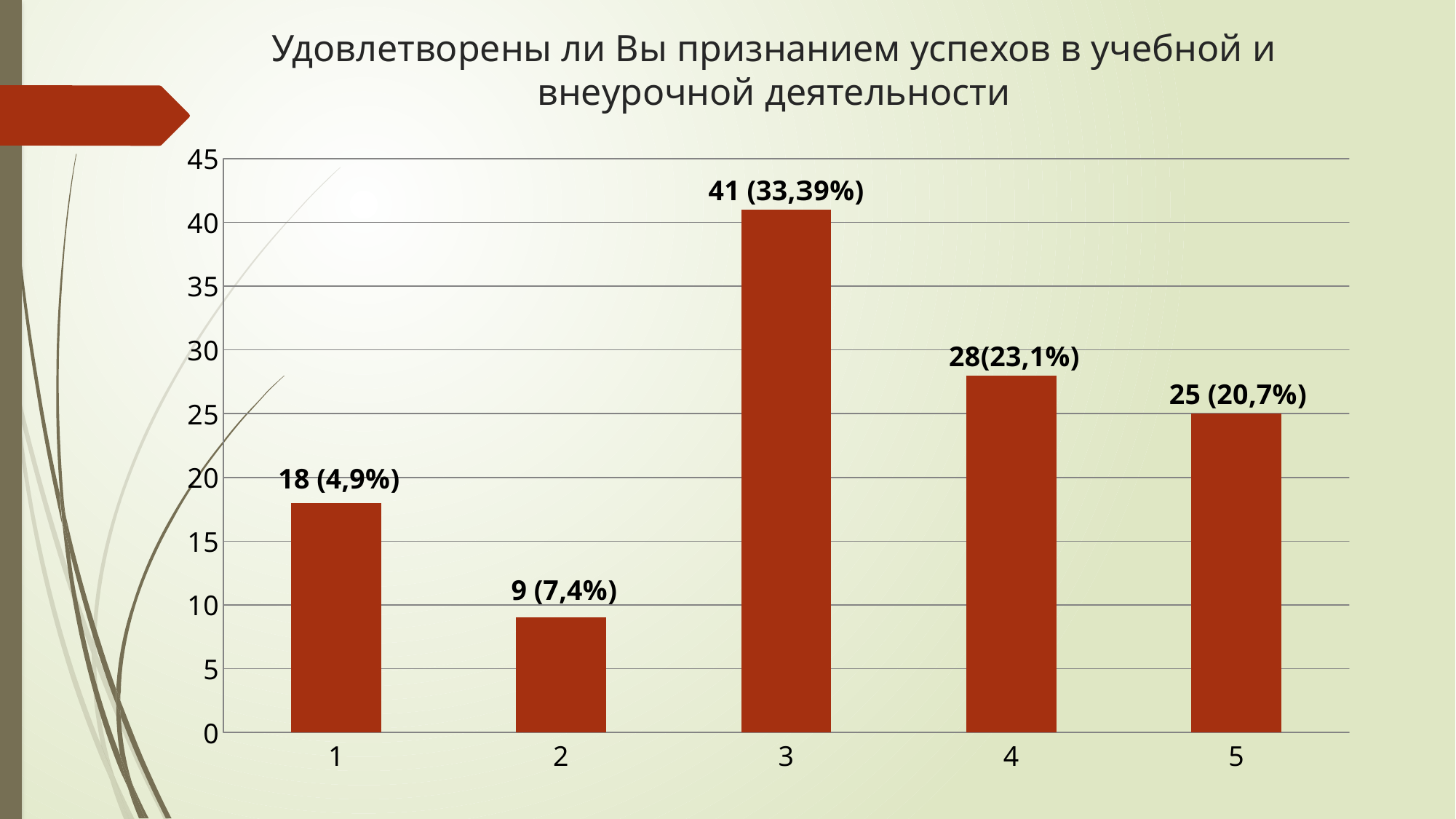
What kind of chart is shown on the slide? bar chart Which category has the highest bar? 3 What is the difference between the count for category 1 and the count for category 2? 9 What is the data label shown for category 1? 18 (4,9%) Which category has the lowest bar? 2 What is the data label shown for category 5? 25 (20,7%) Is the value for category 3 greater or less than 40? greater What is the difference between the count for category 3 and the count for category 4? 13 Which is larger, the value for category 4 or the value for category 5? 4 What is the maximum value shown on the vertical axis? 45 What is the data label shown for category 3? 41 (33,39%) How many categories are shown on the x axis? 5